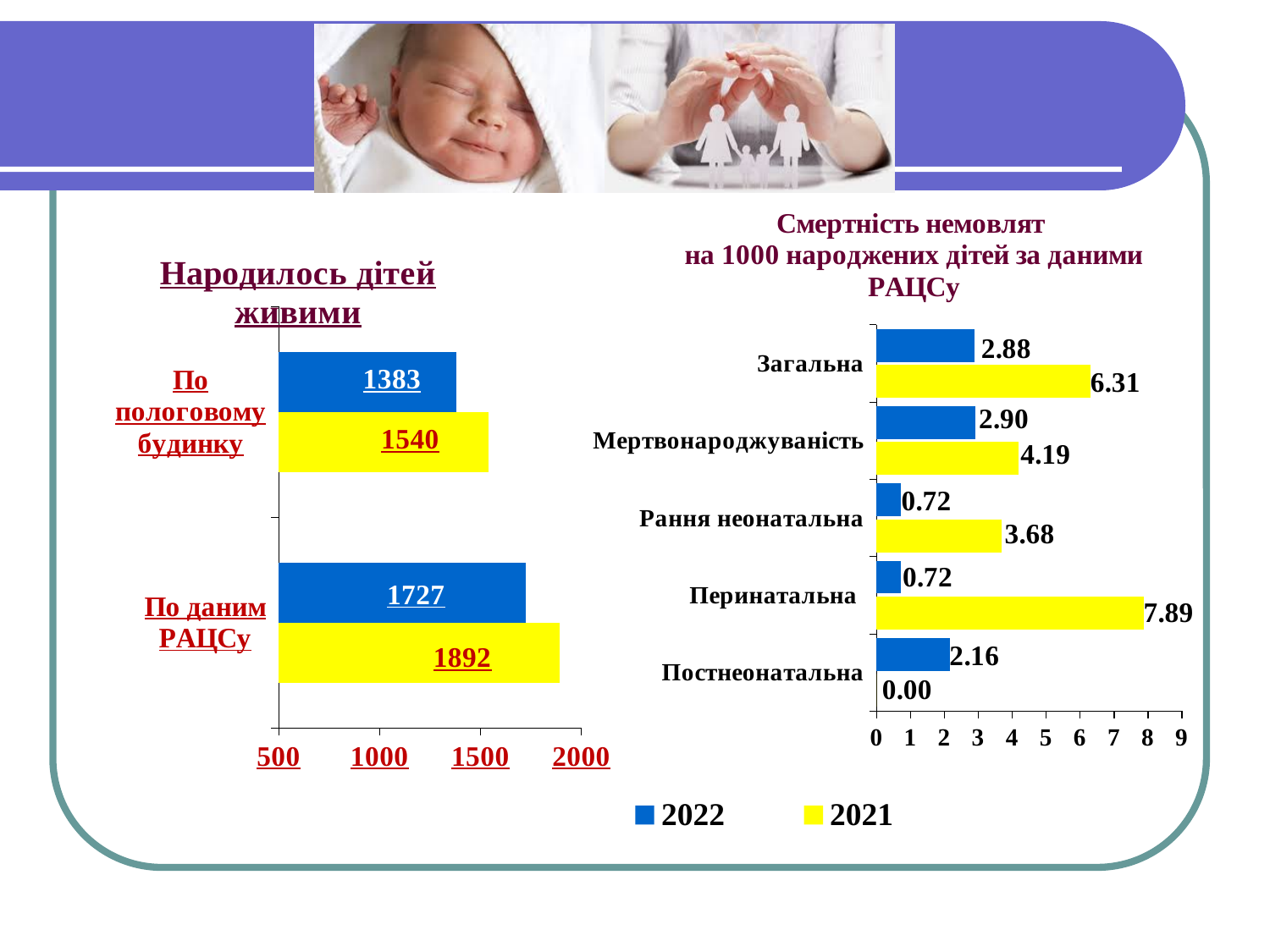
In the chart 'Народилось дітей живими', which is larger for 'По пологовому будинку': the 2022 value or the 2021 value? 2021 In the chart 'Народилось дітей живими', what is the 2021 value for 'По пологовому будинку'? 1540 In the chart 'Смертність немовлят на 1000 народжених дітей за даними РАЦСу', what is the 2022 value for 'Постнеонатальна'? 2.16 In the chart 'Смертність немовлят на 1000 народжених дітей за даними РАЦСу', what is the 2021 value for 'Перинатальна'? 7.89 In the chart 'Народилось дітей живими', what is the 2022 value for 'По даним РАЦСу'? 1727 How many series does the legend at the bottom of the slide list? 2 In the chart 'Народилось дітей живими', what is the difference between the 2021 and 2022 values for 'По даним РАЦСу'? 165 What type of chart is 'Народилось дітей живими'? Bar chart In the chart 'Смертність немовлят на 1000 народжених дітей за даними РАЦСу', which category has the highest 2021 value? Перинатальна In the chart 'Смертність немовлят на 1000 народжених дітей за даними РАЦСу', what is the difference between the 2021 and 2022 values for 'Загальна'? 3.43 How many categories does the chart 'Смертність немовлят на 1000 народжених дітей за даними РАЦСу' show? 5 In the chart 'Смертність немовлят на 1000 народжених дітей за даними РАЦСу', which category has the lowest 2021 value? Постнеонатальна